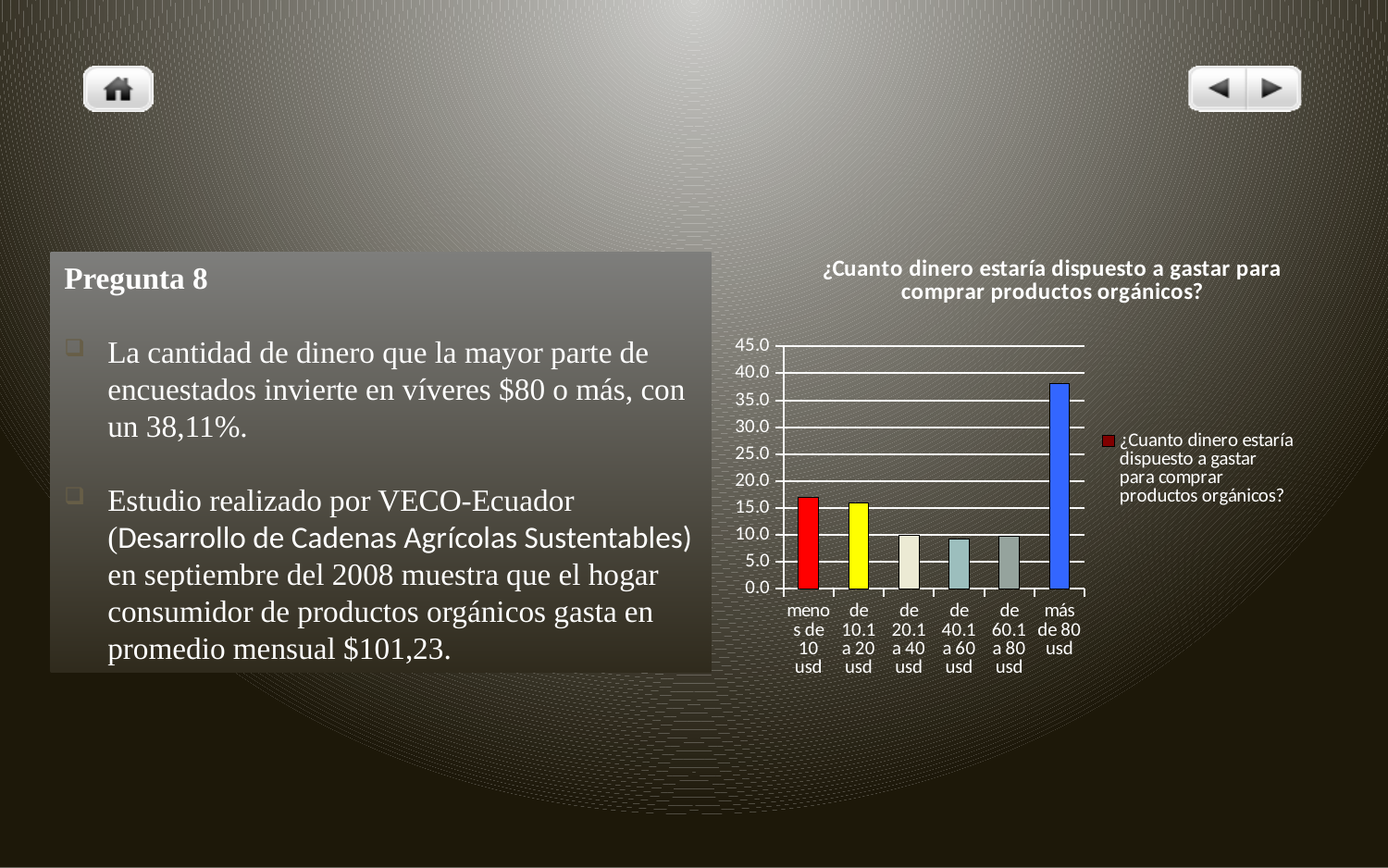
What colour is the bar for 'más de 80 usd'? blue What kind of chart is shown on the slide? bar chart Is the value for 'más de 80 usd' greater or less than 30.0? greater Which category has the highest bar in the chart? más de 80 usd Is the value for 'de 40.1 a 60 usd' greater or less than 15.0? less Which is larger, the value for 'menos de 10 usd' or the value for 'de 20.1 a 40 usd'? menos de 10 usd Is the value for 'de 20.1 a 40 usd' greater or less than 15.0? less Which is larger, the value for 'más de 80 usd' or the value for 'menos de 10 usd'? más de 80 usd How many series does the chart's legend list? 1 How many categories are shown on the x axis of the chart? 6 What is the title of the chart? ¿Cuanto dinero estaría dispuesto a gastar para comprar productos orgánicos?